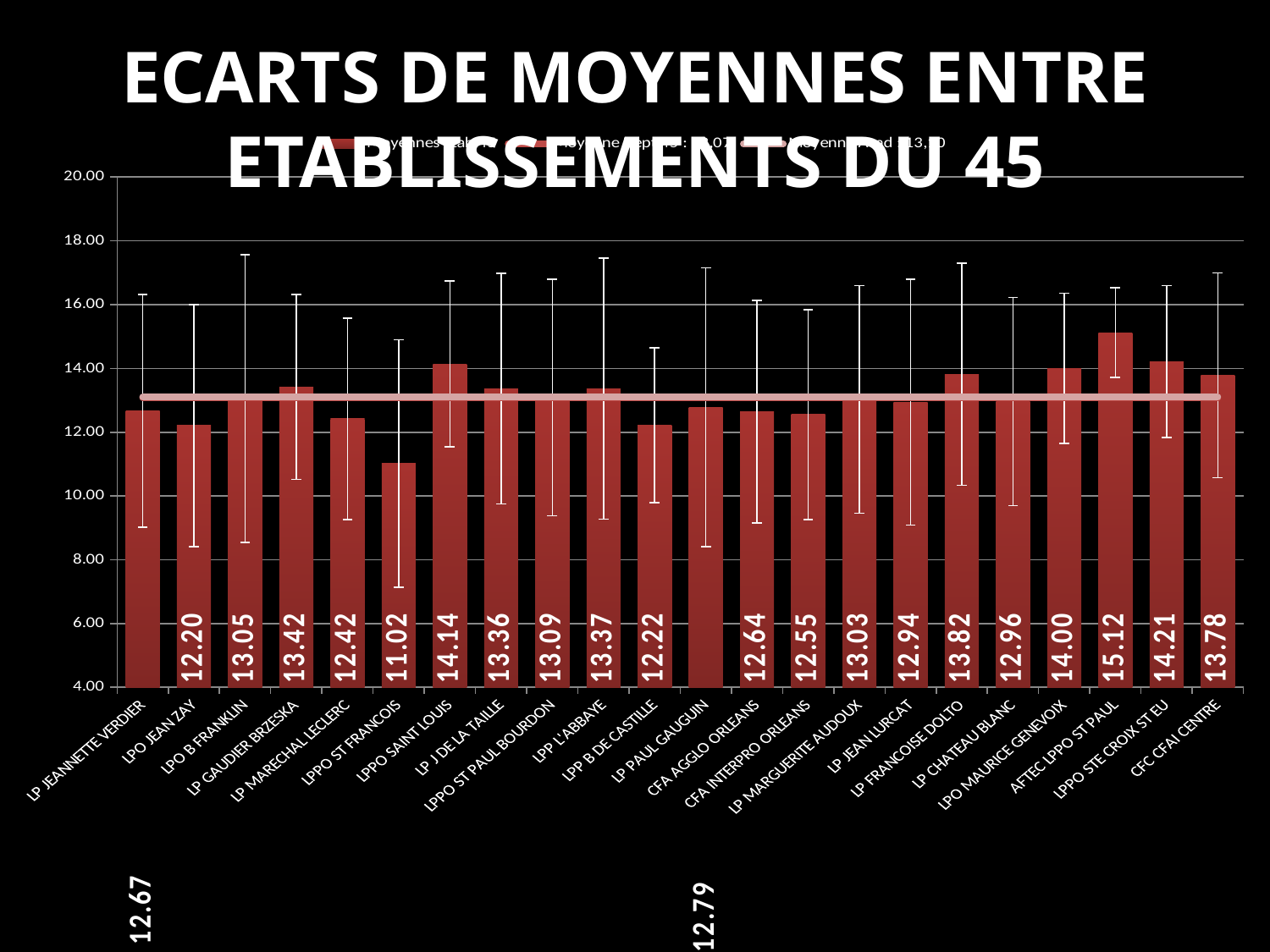
What is the difference between the values for AFTEC LPPO ST PAUL and LPPO ST FRANCOIS? 4.10 What is the difference between the values for LPPO STE CROIX ST EU and CFC CFAI CENTRE? 0.43 What kind of chart is this? Bar chart What is the value for AFTEC LPPO ST PAUL? 15.12 What is the value for LP FRANCOISE DOLTO? 13.82 What is the value for LPO MAURICE GENEVOIX? 14.00 Which is larger, the value for LPPO SAINT LOUIS or the value for LP GAUDIER BRZESKA? LPPO SAINT LOUIS What is the value for LPPO ST FRANCOIS? 11.02 What is the title of the chart? ECARTS DE MOYENNES ENTRE ETABLISSEMENTS DU 45 Which establishment has the lowest value? LPPO ST FRANCOIS Which establishment has the highest value? AFTEC LPPO ST PAUL How many establishments are shown on the x axis? 22